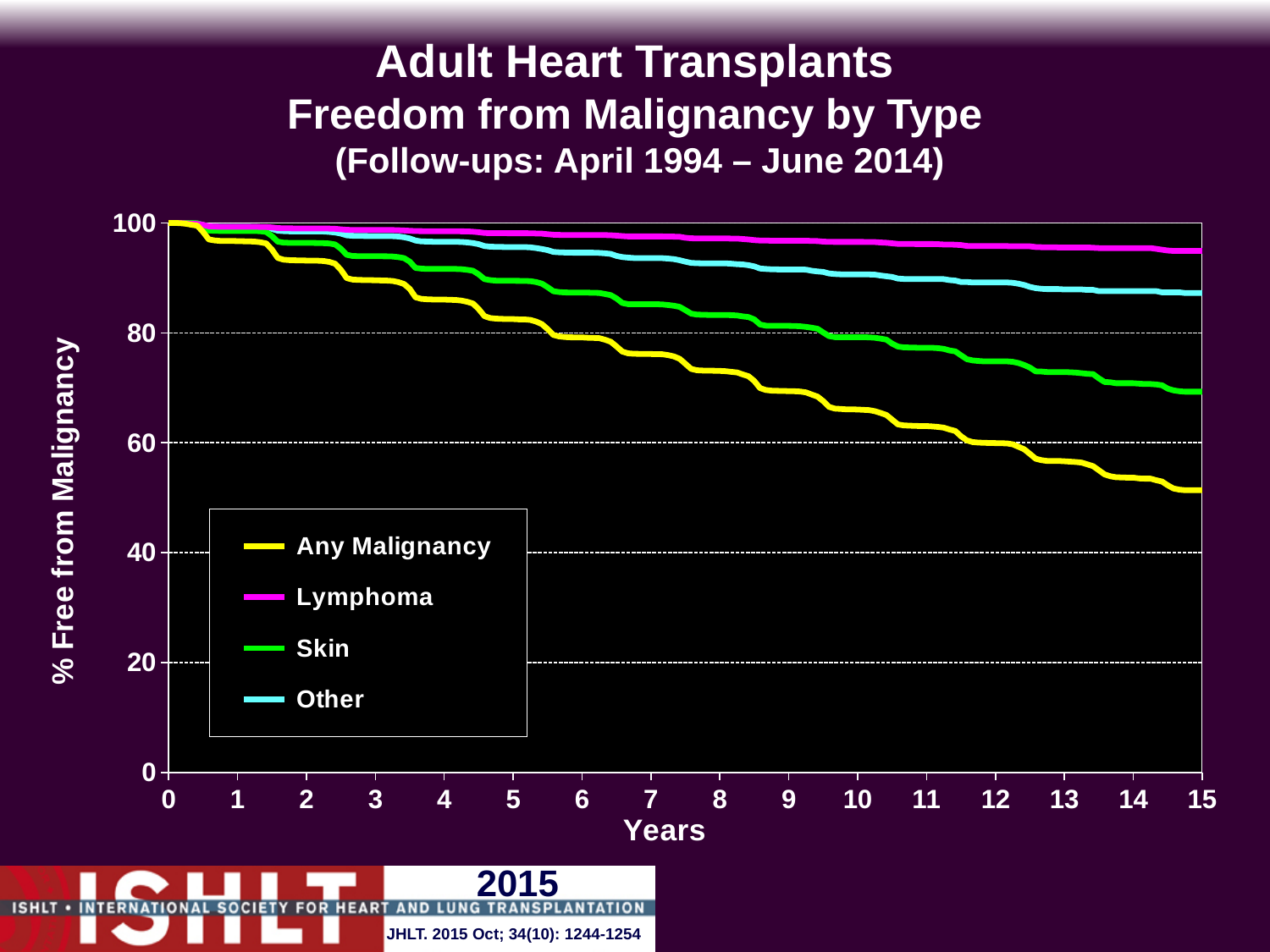
At 15 years, which is higher: the Skin series or the Other series? Other Is the value for Skin at 15 years greater or less than 60? greater Is the value for Lymphoma at 15 years greater or less than 80? greater What kind of chart is shown on the slide? line chart Is the value for Any Malignancy at 10 years greater or less than 60? greater Which series has the highest % free from malignancy at 15 years? Lymphoma What is the label of the y axis? % Free from Malignancy Which colour is used for the Skin series? green How many series does the legend list? 4 Do the values for Any Malignancy rise or fall as years increase? fall Which series has the lowest % free from malignancy at 15 years? Any Malignancy